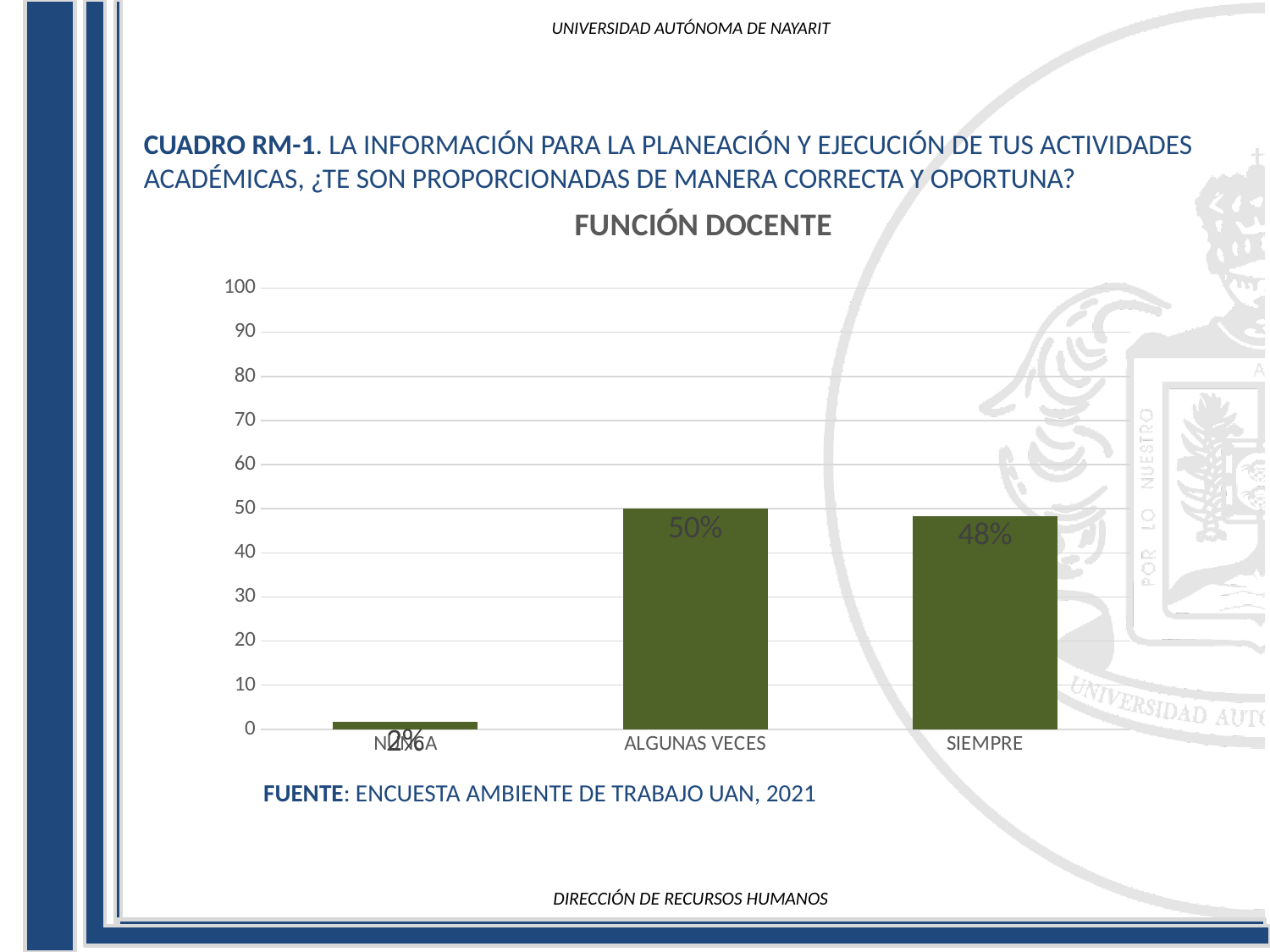
What is the value for NUNCA? 2% What kind of chart is shown under the title FUNCIÓN DOCENTE? bar chart Which category has the highest value? ALGUNAS VECES How many categories are shown on the x axis of the chart? 3 What is the value for ALGUNAS VECES? 50% What is the difference between the values for ALGUNAS VECES and SIEMPRE? 2% Which is larger, the value for SIEMPRE or the value for NUNCA? SIEMPRE Is the value for SIEMPRE greater or less than 40? greater What is the difference between the values for SIEMPRE and NUNCA? 46% What is the title of the chart? FUNCIÓN DOCENTE Which category has the lowest value? NUNCA What is the value for SIEMPRE? 48%